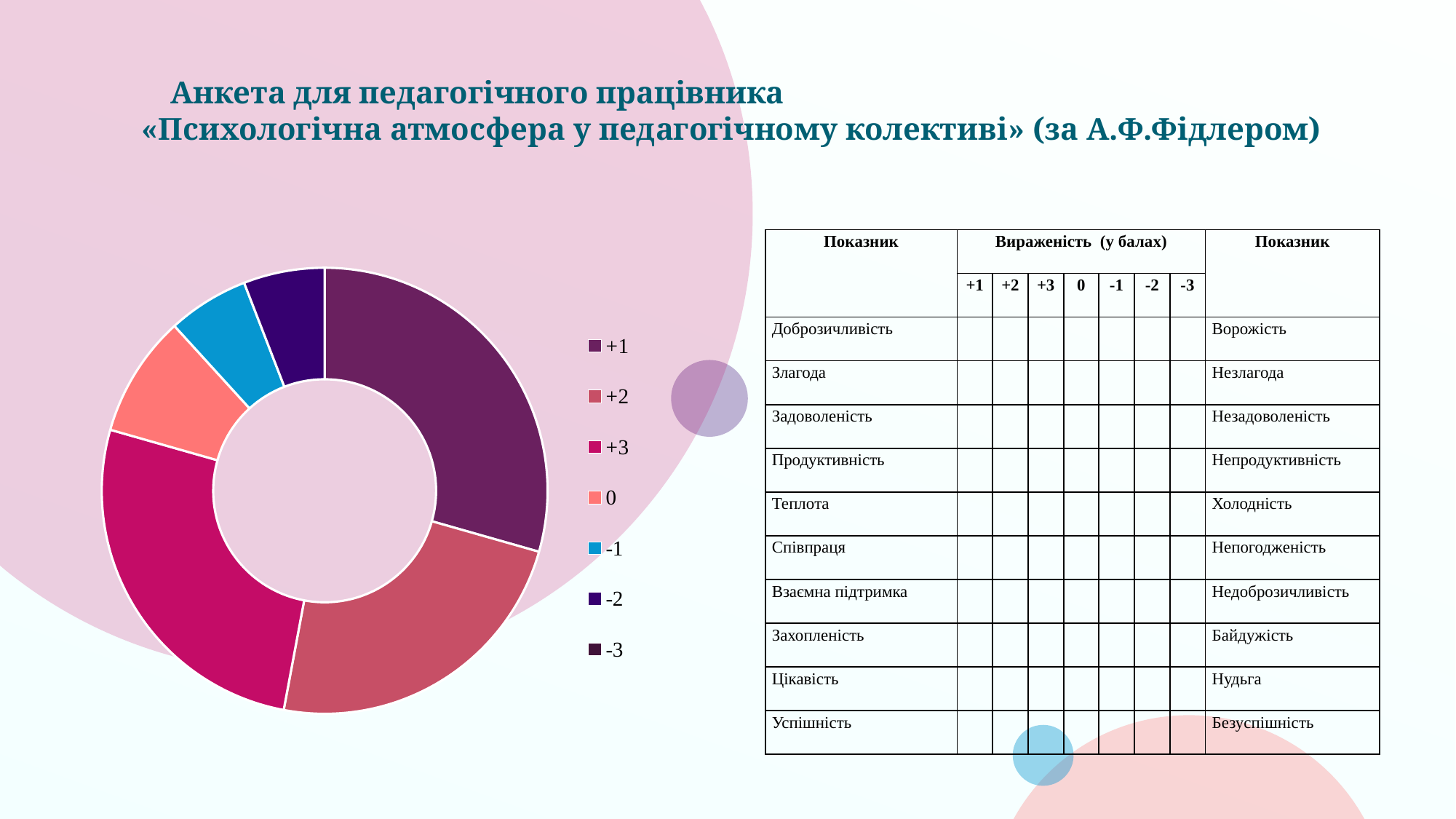
What colour is the +3 slice in the doughnut chart? magenta (pink-red) In the doughnut chart, which slice is larger, +3 or 0? +3 What colour is the -1 slice in the doughnut chart? blue How many categories are listed in the legend of the doughnut chart? 7 How many entries does the legend of the doughnut chart list? 7 Which category has the largest slice in the doughnut chart? +1 In the doughnut chart, which slice is larger, +2 or -1? +2 What kind of chart is shown on the left of the slide? doughnut chart In the doughnut chart, which slice is larger, +1 or +2? +1